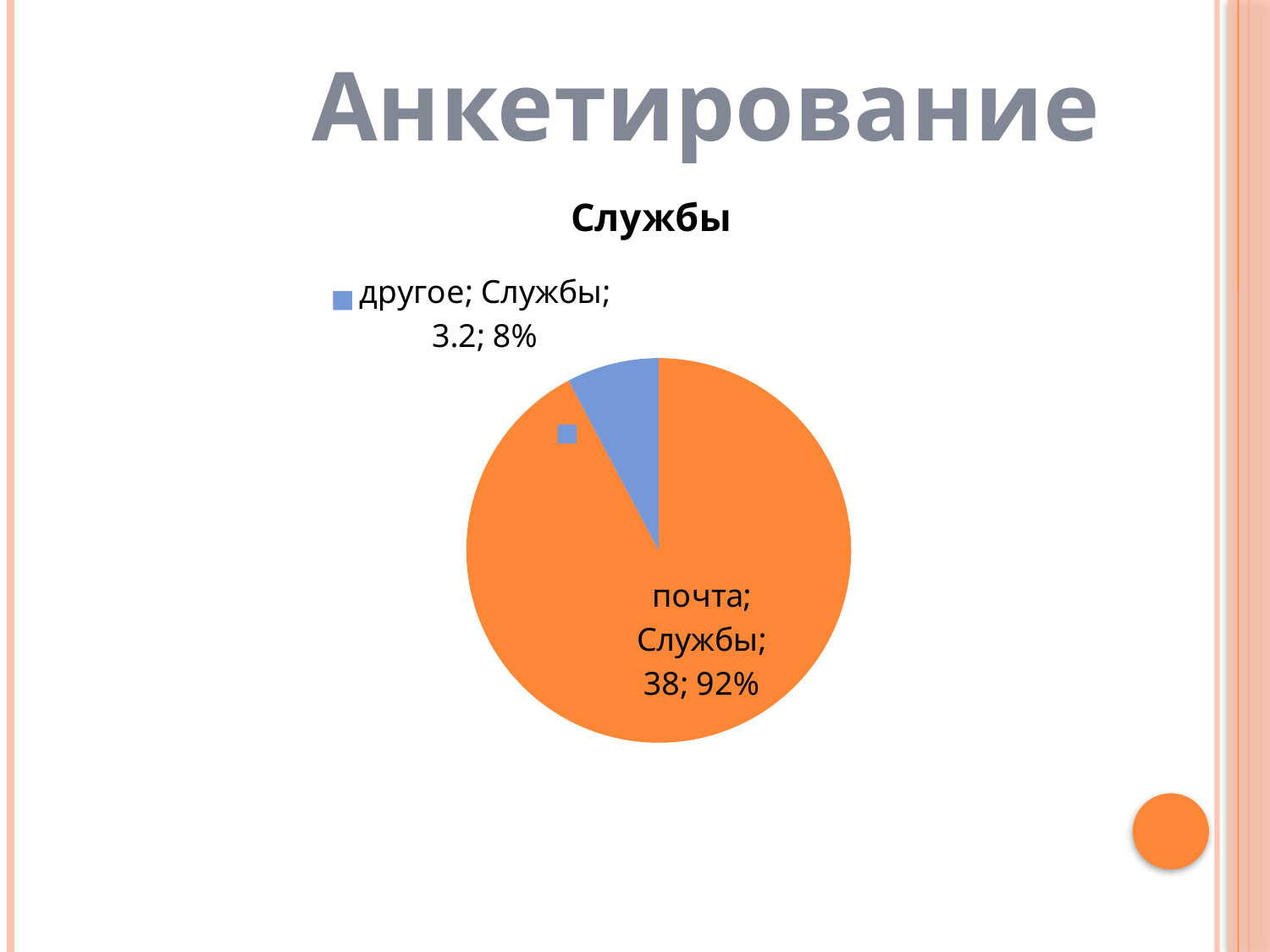
What is the title of the chart? Службы How many slices does the pie chart have? 2 Which is larger, the 'почта' slice or the 'другое' slice? почта What value is shown for the 'другое' slice? 3.2 Which slice is the smallest? другое What percentage share does the 'другое' slice have? 8% What value is shown for the 'почта' slice? 38 What colour is the 'почта' slice? orange What percentage share does the 'почта' slice have? 92% What is the difference between the values for 'почта' and 'другое'? 34.8 Which slice is the largest? почта What type of chart is shown on the slide? pie chart